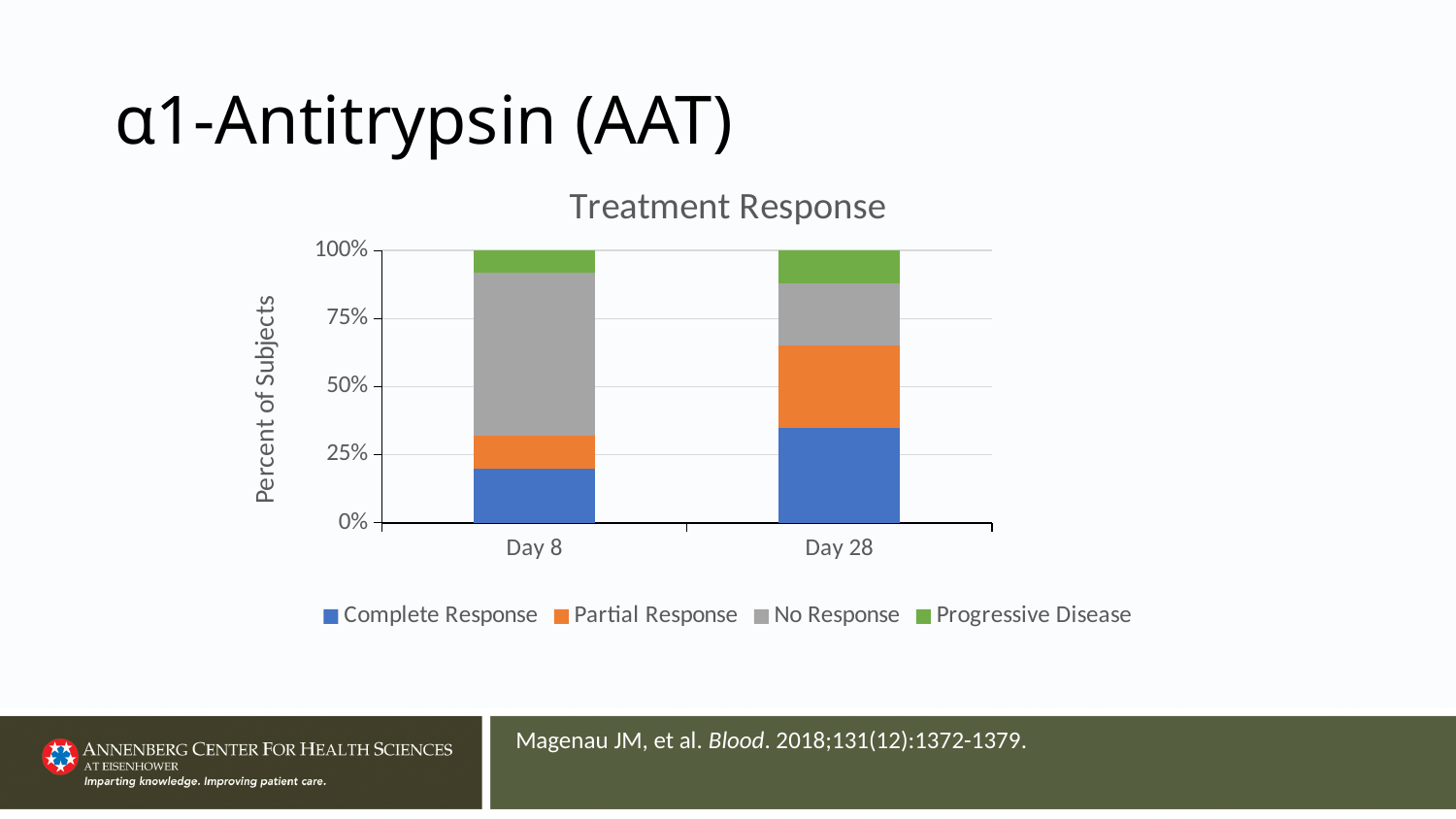
How many series does the legend of the Treatment Response chart list? 4 What is the total height of the Day 28 stacked bar? 100% How many categories are shown on the x axis of the Treatment Response chart? 2 Which legend entry is shown in green in the Treatment Response chart? Progressive Disease Which response category makes up the largest share of the Day 8 bar? No Response Is the No Response share larger on Day 8 or Day 28? Day 8 What is the y-axis label of the Treatment Response chart? Percent of Subjects Is the Complete Response share larger on Day 8 or Day 28? Day 28 Is the Complete Response value for Day 28 greater or less than 25%? greater Is the Complete Response value for Day 8 greater or less than 25%? less What kind of chart is shown under the title "Treatment Response"? Stacked bar chart Is the No Response value for Day 8 greater or less than 50%? greater